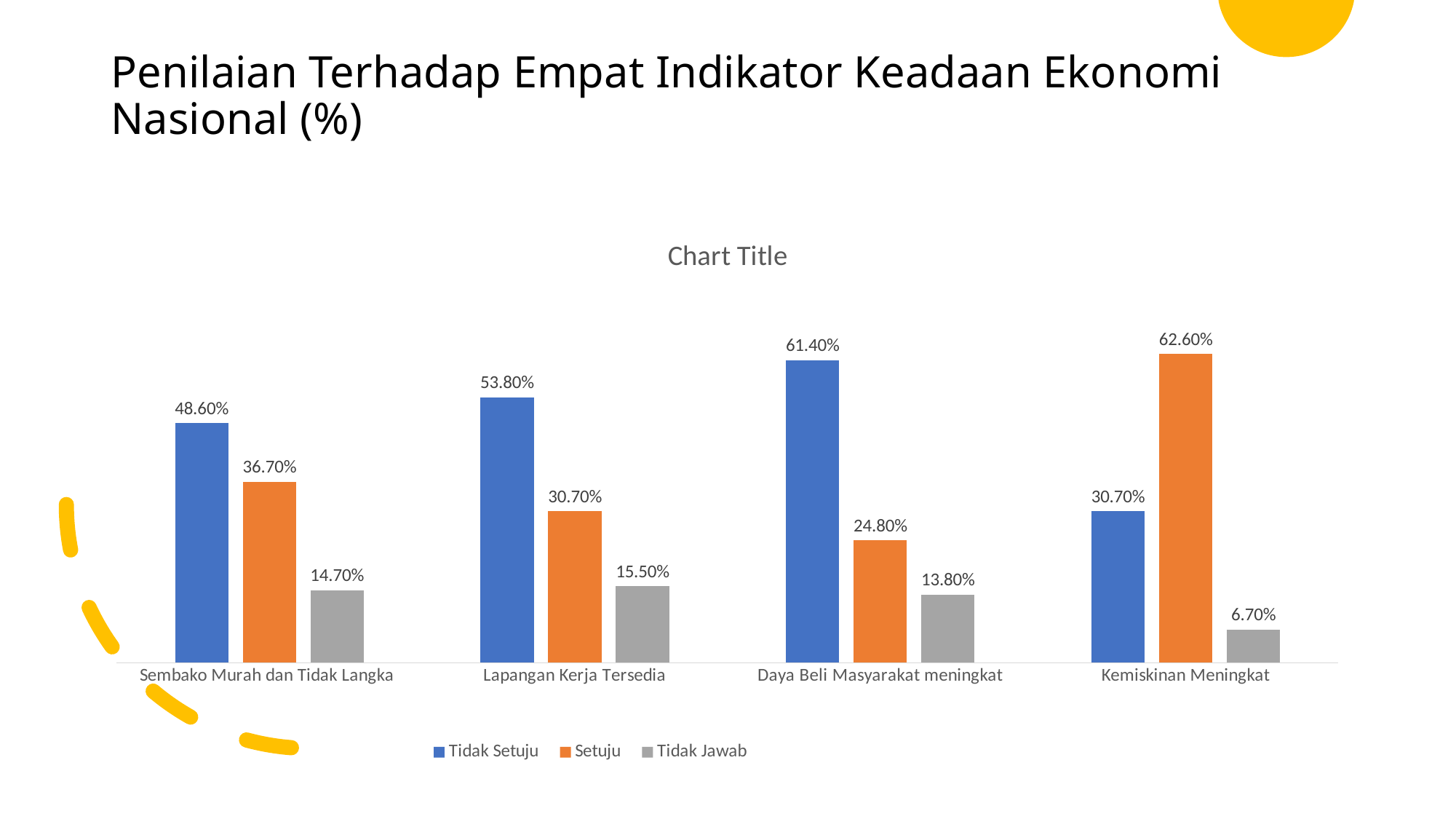
Which category has the lowest Tidak Jawab value? Kemiskinan Meningkat Which category has the highest Tidak Setuju value? Daya Beli Masyarakat meningkat What is the difference between the Tidak Setuju and Setuju values for Daya Beli Masyarakat meningkat? 36.60% What is the Setuju value for Daya Beli Masyarakat meningkat? 24.80% Which is larger for Lapangan Kerja Tersedia: Tidak Setuju or Setuju? Tidak Setuju How many categories are shown on the x axis? 4 What is the Tidak Setuju value for Sembako Murah dan Tidak Langka? 48.60% What is the Setuju value for Kemiskinan Meningkat? 62.60% Which colour represents the Setuju series in the legend? Orange What is the Tidak Jawab value for Lapangan Kerja Tersedia? 15.50% What kind of chart is shown on the slide? Bar chart How many series does the legend list? 3